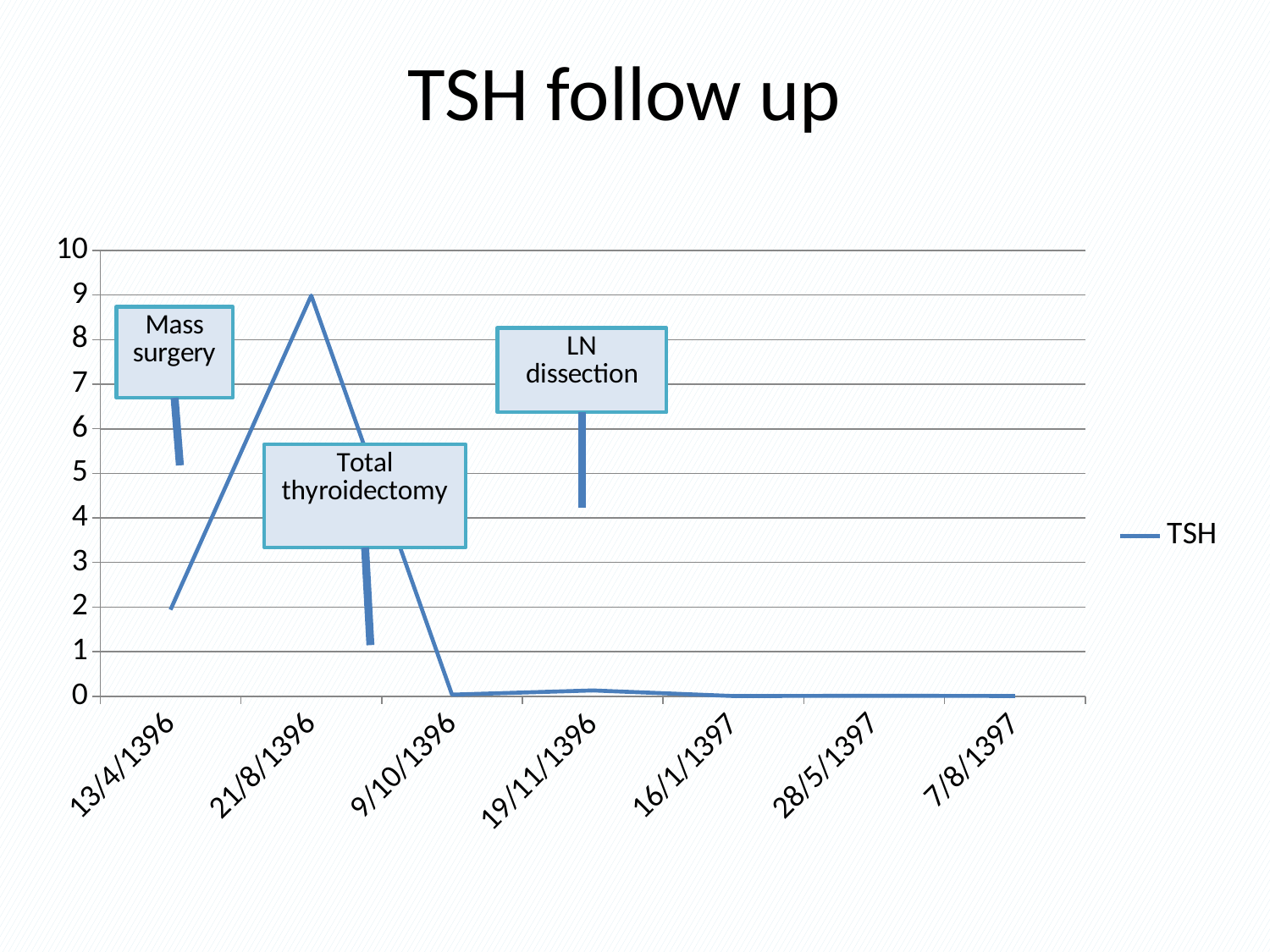
Is the TSH value on 9/10/1396 greater or less than 1? less Is the TSH value on 13/4/1396 greater or less than 5? less How many series does the legend list? 1 Which date has the larger TSH value, 13/4/1396 or 16/1/1397? 13/4/1396 Is the TSH value on 21/8/1396 greater or less than 8? greater How many dates are plotted along the x axis? 7 What is the title of the chart? TSH follow up Does the TSH value rise or fall between 21/8/1396 and 9/10/1396? fall What kind of chart is shown on the slide? line chart On which date is the TSH value highest? 21/8/1396 What event is labelled in the callout box between the 21/8/1396 and 9/10/1396 points? Total thyroidectomy